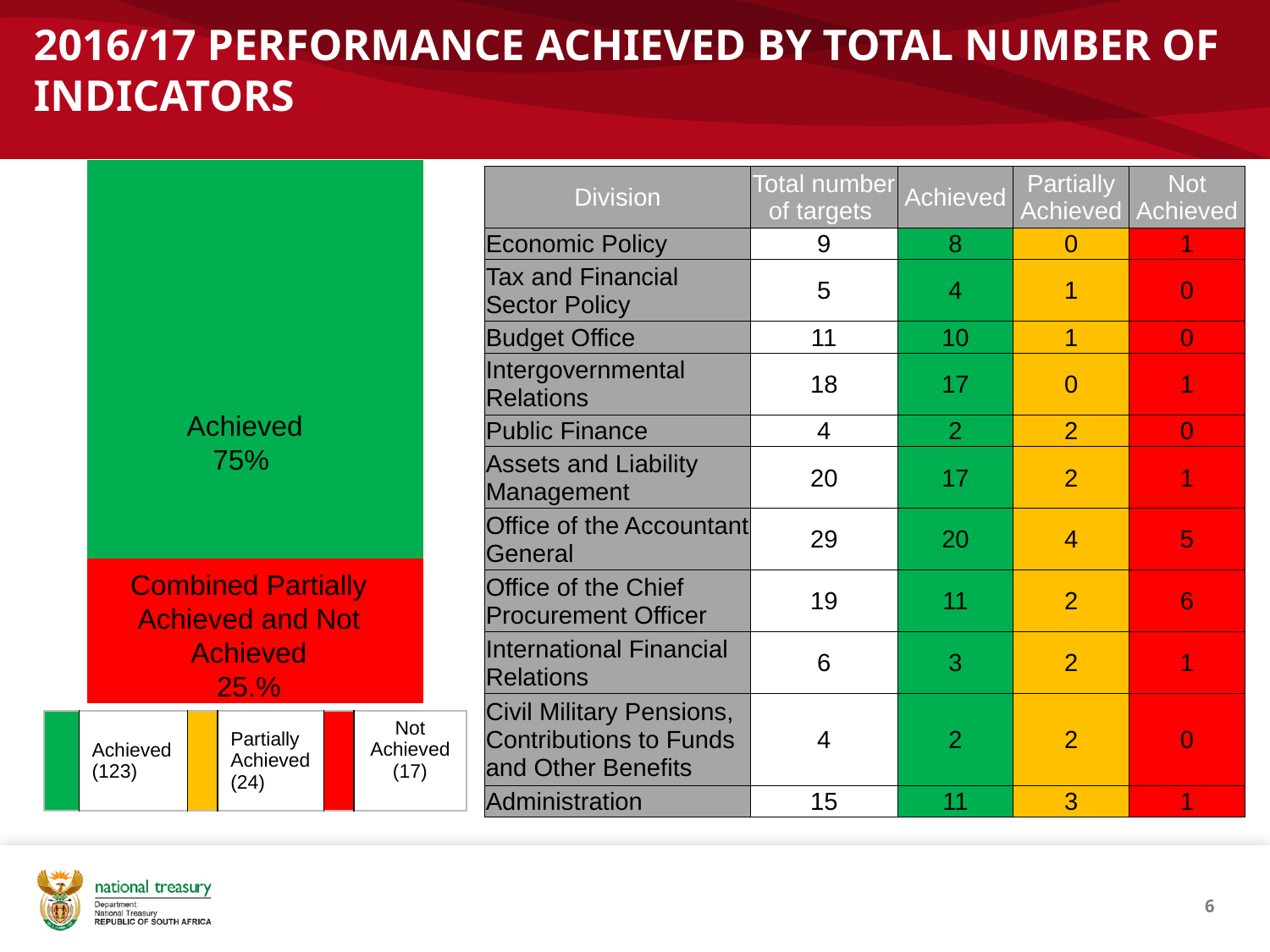
How many segments does the stacked bar in the chart have? 2 According to the chart legend, how many indicators were Partially Achieved? 24 What percentage of indicators does the chart show as Achieved? 75% Which segment of the chart is larger, Achieved or Combined Partially Achieved and Not Achieved? Achieved What is the difference in percentage points between the Achieved segment and the Combined Partially Achieved and Not Achieved segment? 50 According to the chart legend, how many indicators were Achieved? 123 What percentage does the chart show for Combined Partially Achieved and Not Achieved? 25.% How many entries does the chart's legend list? 3 According to the chart legend, how many indicators were Not Achieved? 17 What colour does the chart legend use for Partially Achieved? Yellow What colour is the Achieved segment of the chart? Green What kind of chart is shown on the left of the slide? Stacked bar chart